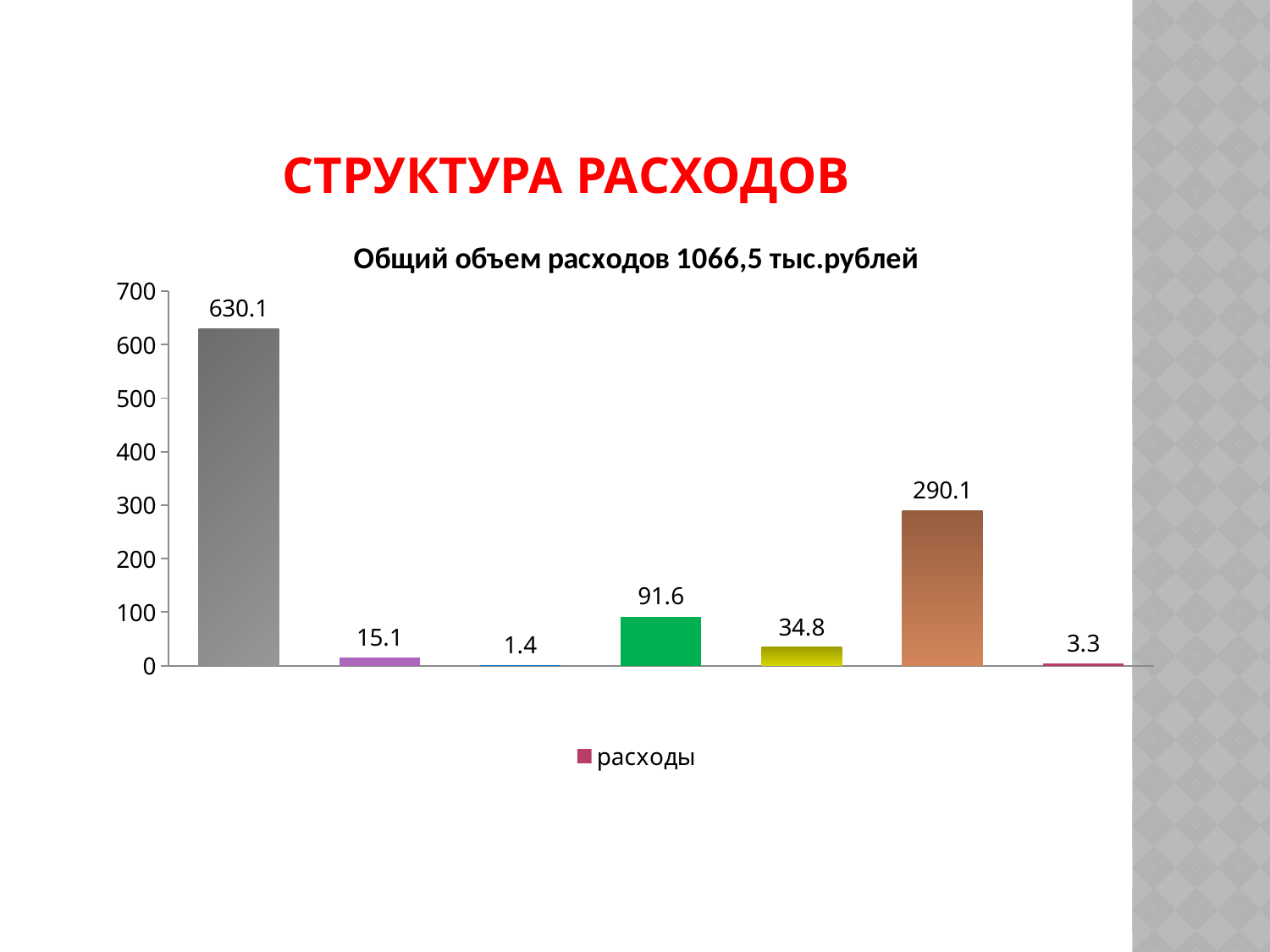
How many series does the legend list? 1 What is the value shown on the brown bar, the sixth from the left? 290.1 What is the value shown on the first (gray) bar of the chart? 630.1 What is the value shown on the yellow bar, the fifth from the left? 34.8 What is the difference between the first bar (630.1) and the sixth bar (290.1)? 340 Which bar has the highest value in the chart? The first (gray) bar, 630.1 How many bars are plotted in the chart? 7 Which is larger: the value of the second bar (15.1) or the value of the last bar (3.3)? The second bar, 15.1 What type of chart is shown on the slide? Bar chart What is the title of the chart? Общий объем расходов 1066,5 тыс.рублей Which bar has the lowest value in the chart? The third (blue) bar, 1.4 What is the value shown on the green bar in the middle of the chart? 91.6